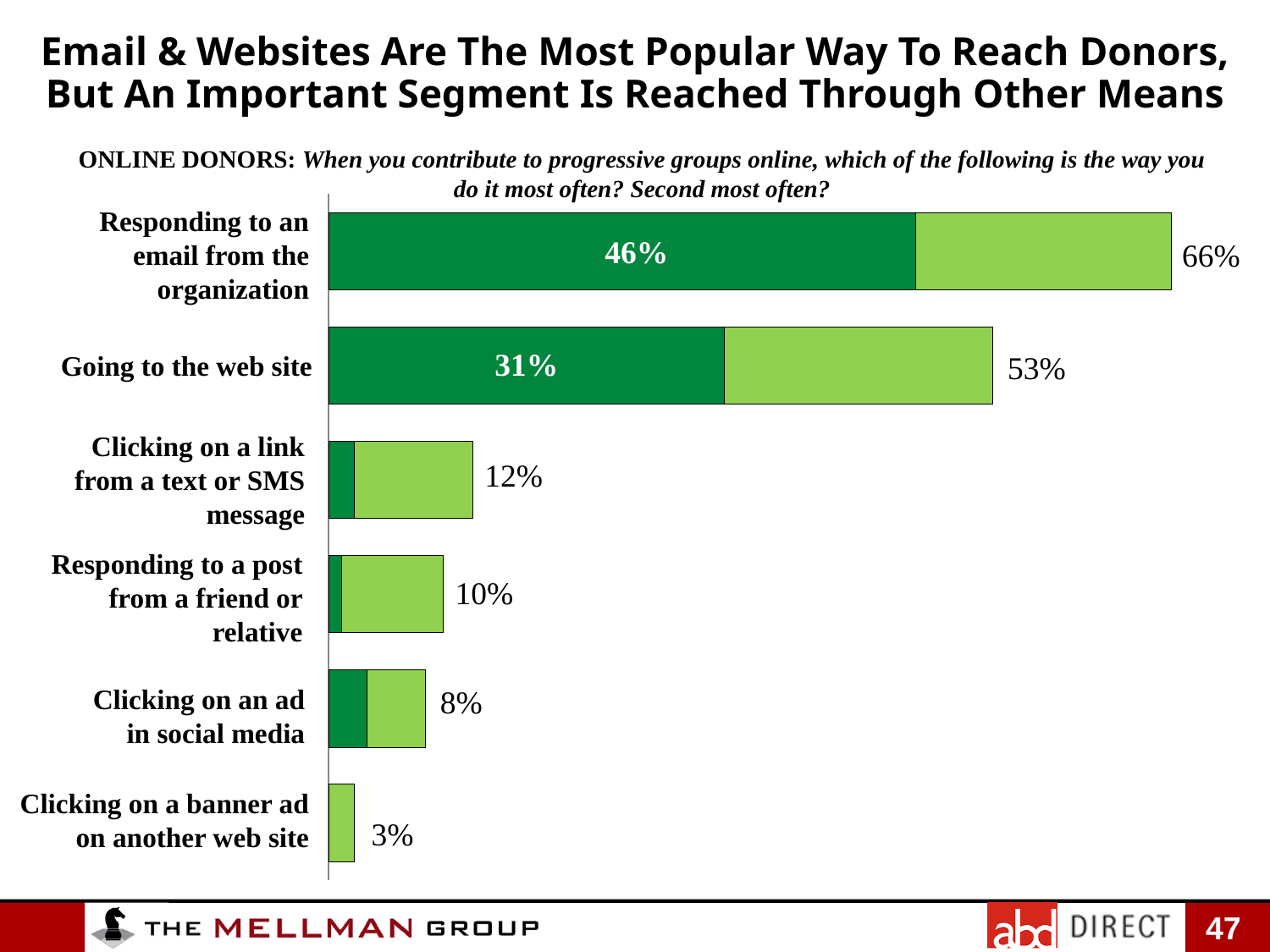
What is the value shown for "Clicking on a banner ad on another web site"? 3% What is the total value shown for "Responding to an email from the organization"? 66% Which is larger: the value for "Responding to a post from a friend or relative" or the value for "Clicking on an ad in social media"? Responding to a post from a friend or relative How many categories are shown in the chart? 6 What value is printed inside the dark green segment of the "Going to the web site" bar? 31% Which category has the lowest value? Clicking on a banner ad on another web site What is the value shown for "Clicking on a link from a text or SMS message"? 12% What is the difference between the total for "Responding to an email from the organization" (66%) and the total for "Going to the web site" (53%)? 13% What value is printed inside the dark green segment of the "Responding to an email from the organization" bar? 46% Which category has the highest total value? Responding to an email from the organization What kind of chart is shown on the slide? Bar chart What is the total value shown for "Going to the web site"? 53%